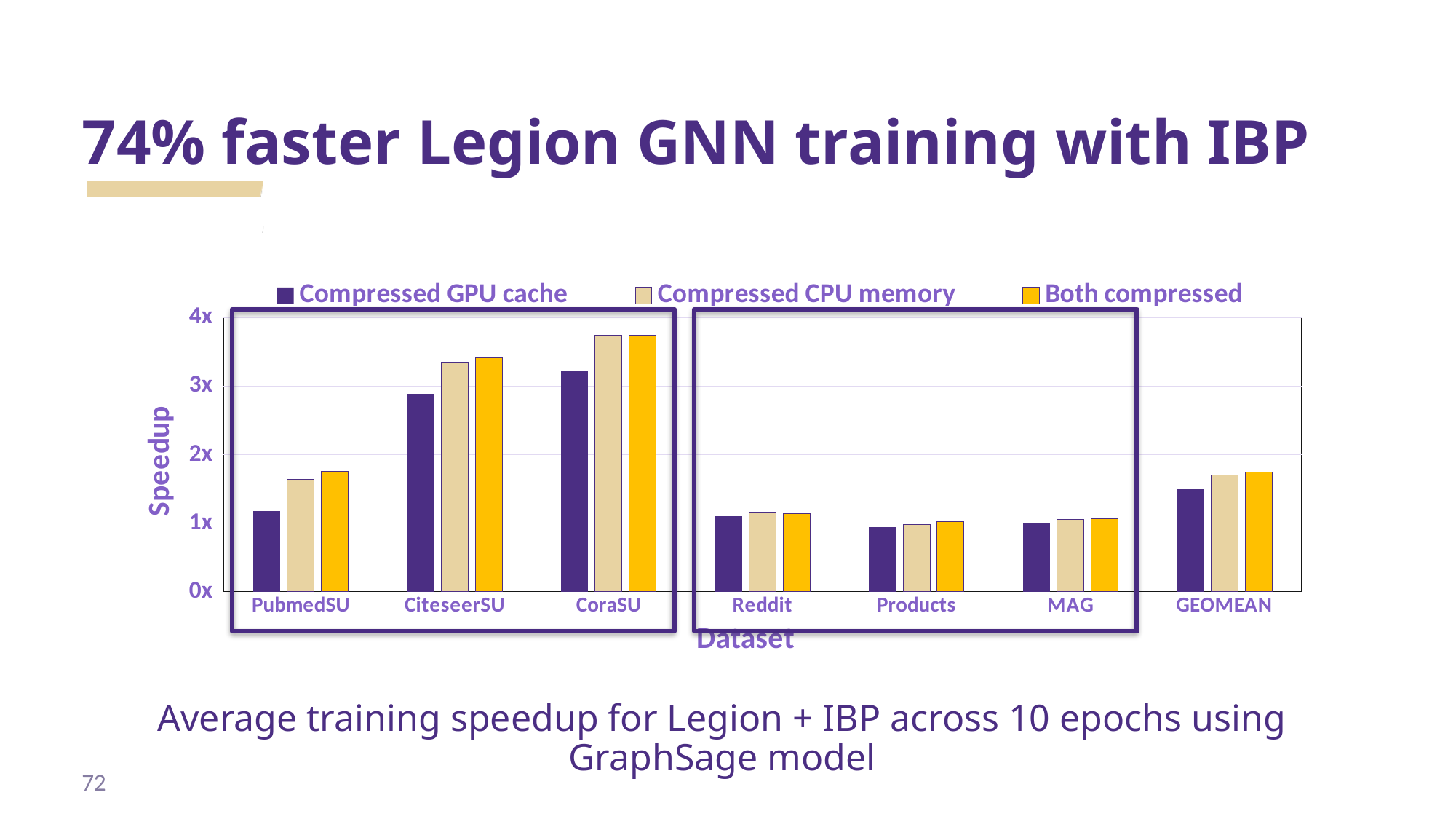
What are the three legend entries of the chart? Compressed GPU cache, Compressed CPU memory, Both compressed What kind of chart is shown on the slide? bar chart Is the Compressed CPU memory speedup for CoraSU greater or less than 3x? greater Which has the larger Both compressed speedup, CiteseerSU or Reddit? CiteseerSU Is the Compressed GPU cache speedup for CoraSU greater or less than 3x? greater Is the Both compressed speedup for GEOMEAN greater or less than 2x? less How many series does the legend list? 3 Which dataset has the highest Both compressed speedup? CoraSU Which has the larger Compressed GPU cache speedup, CoraSU or CiteseerSU? CoraSU What is the label of the y axis? Speedup How many datasets are shown along the x axis? 7